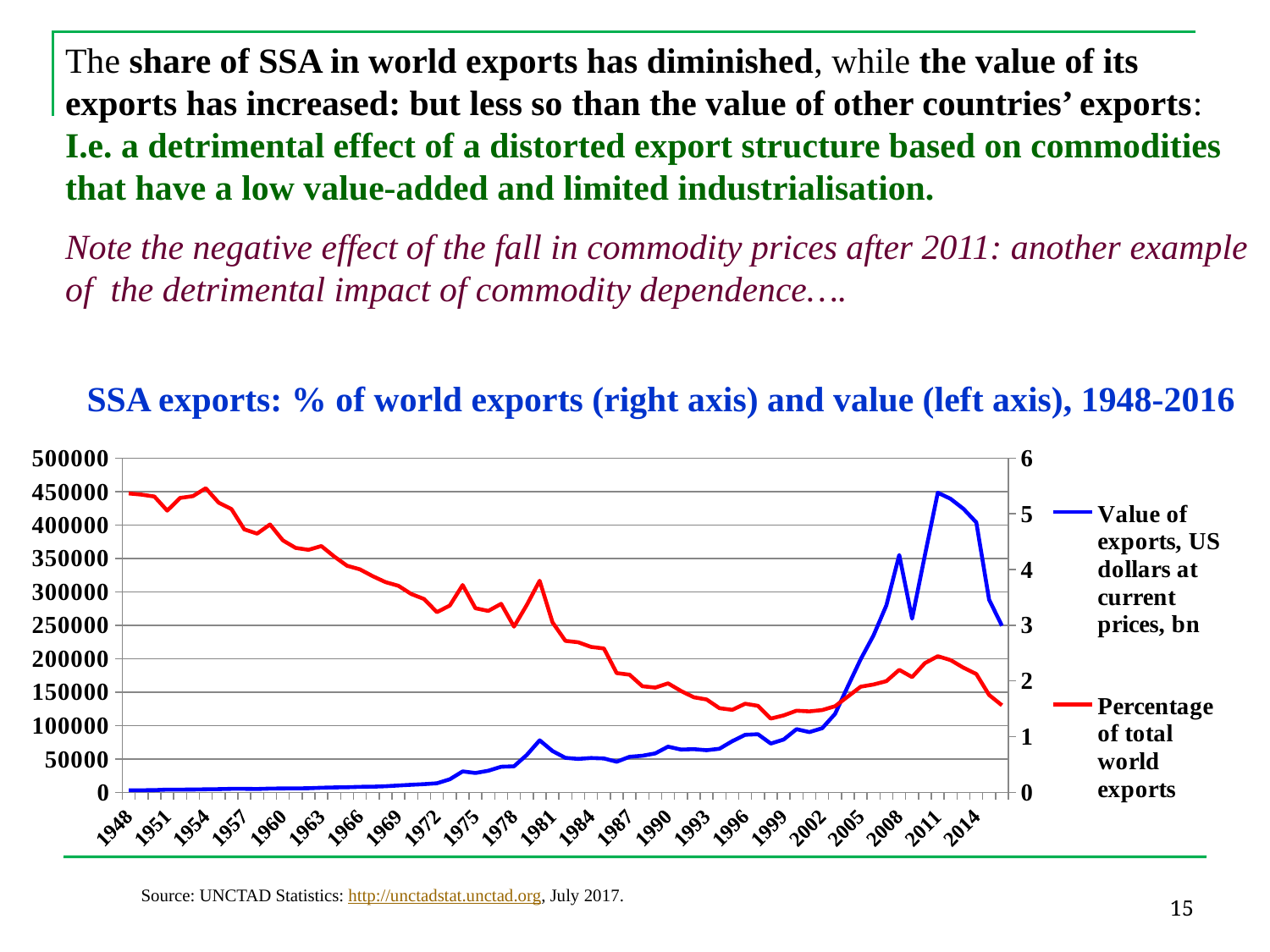
Is the percentage of total world exports in 1948 greater or less than 5? greater Does the 'Value of exports, US dollars at current prices, bn' series generally rise or fall from 1948 to 2011? rise Is the value of exports in 1990 greater or less than 100000? less Is the value of exports in 2011 greater or less than 400000? greater How many series does the legend list? 2 Which is larger: the percentage of total world exports in 1948 or in 2016? 1948 Does the 'Percentage of total world exports' series generally rise or fall from 1948 to 2016? fall In which year does the 'Value of exports' series reach its highest point? 2011 What kind of chart is shown on the slide? line chart What is the title of the chart? SSA exports: % of world exports (right axis) and value (left axis), 1948-2016 Which colour is used for the 'Percentage of total world exports' series? red